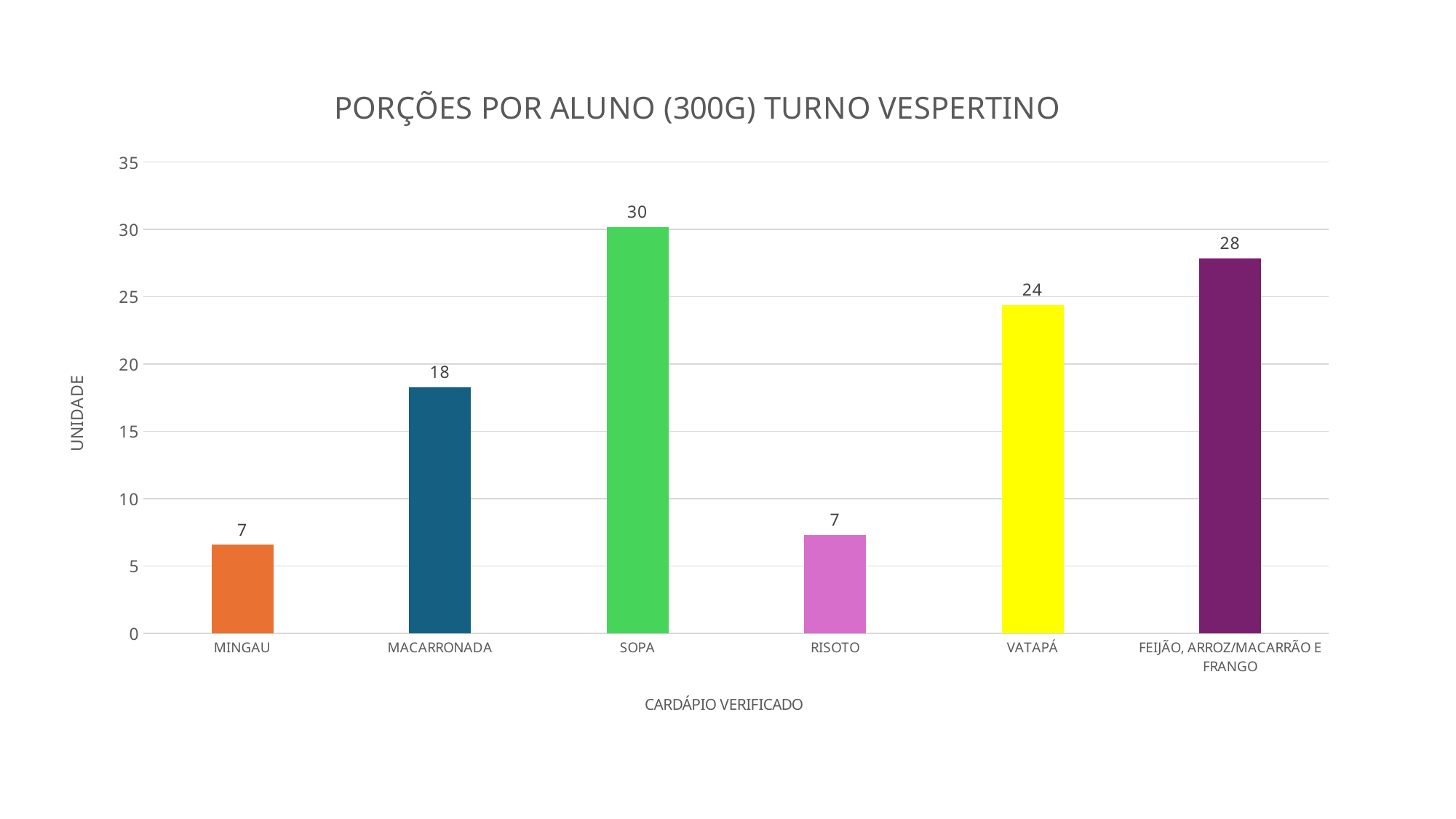
How many categories are shown on the x axis? 6 What is the difference between the values for SOPA and MACARRONADA? 12 What is the value for MACARRONADA? 18 Is the value for RISOTO greater or less than 10? less Which category has the highest value? SOPA What kind of chart is shown on the slide? bar chart What is the value for FEIJÃO, ARROZ/MACARRÃO E FRANGO? 28 What is the title of the chart? PORÇÕES POR ALUNO (300G) TURNO VESPERTINO What is the value for SOPA? 30 Which is larger, the value for VATAPÁ or the value for MACARRONADA? VATAPÁ What is the value for VATAPÁ? 24 What is the difference between the values for FEIJÃO, ARROZ/MACARRÃO E FRANGO and VATAPÁ? 4